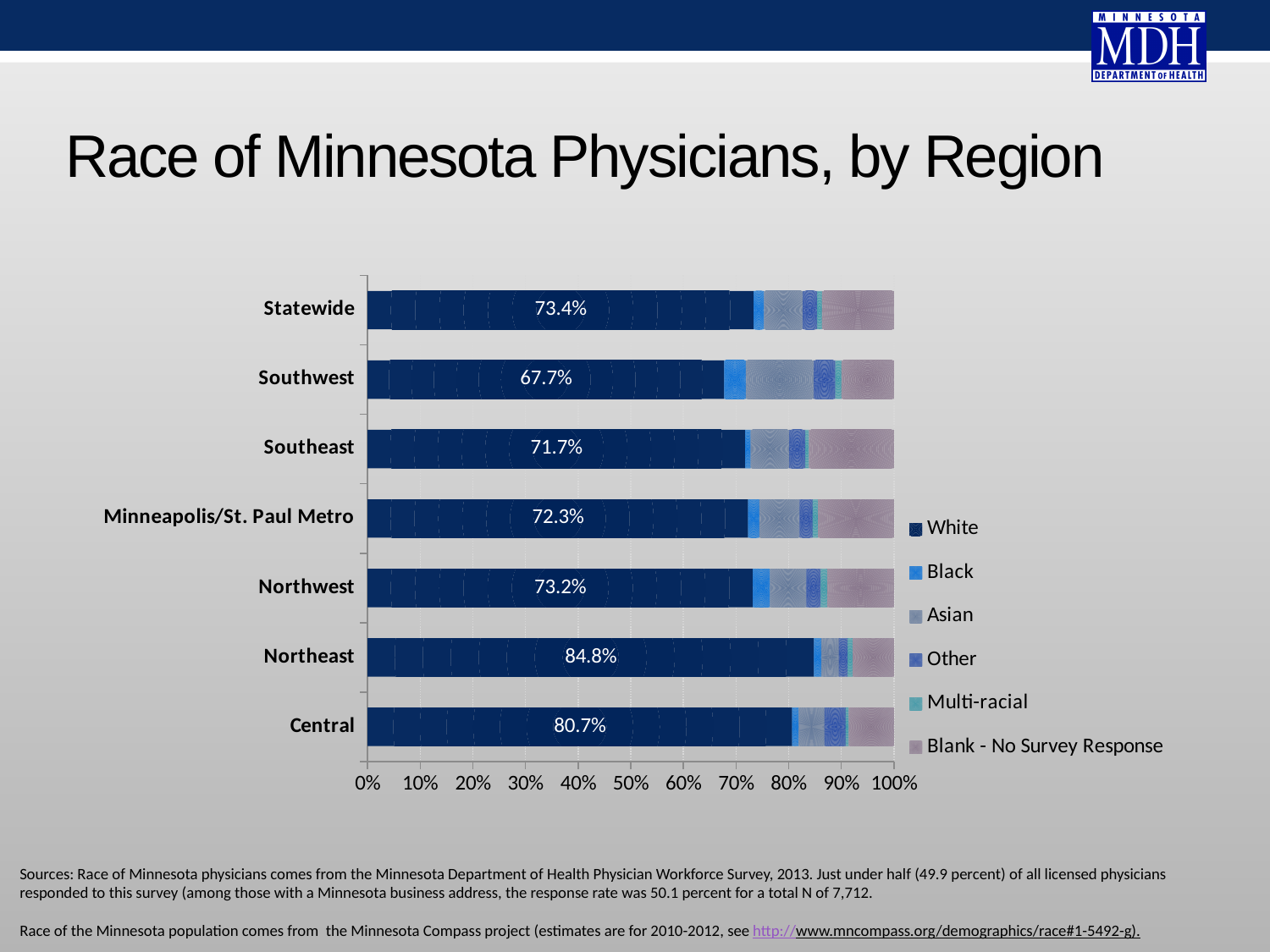
How many percentage points higher is the White share in the Northeast than in the Southwest? 17.1 percentage points What is the White share of physicians in the Southwest region? 67.7% How many race categories does the legend list? 6 How many regions (bars) are shown in the chart, including Statewide? 7 Which region has the lowest White share of physicians? Southwest Which region has the highest White share of physicians? Northeast Which has a larger White share of physicians, the Central region or the Southeast region? Central What type of chart is shown on the slide? Stacked bar chart What is the White share of physicians for the Statewide bar? 73.4% What is the title of the chart on the slide? Race of Minnesota Physicians, by Region What is the White share of physicians in the Minneapolis/St. Paul Metro region? 72.3% What is the White share of physicians in the Central region? 80.7%